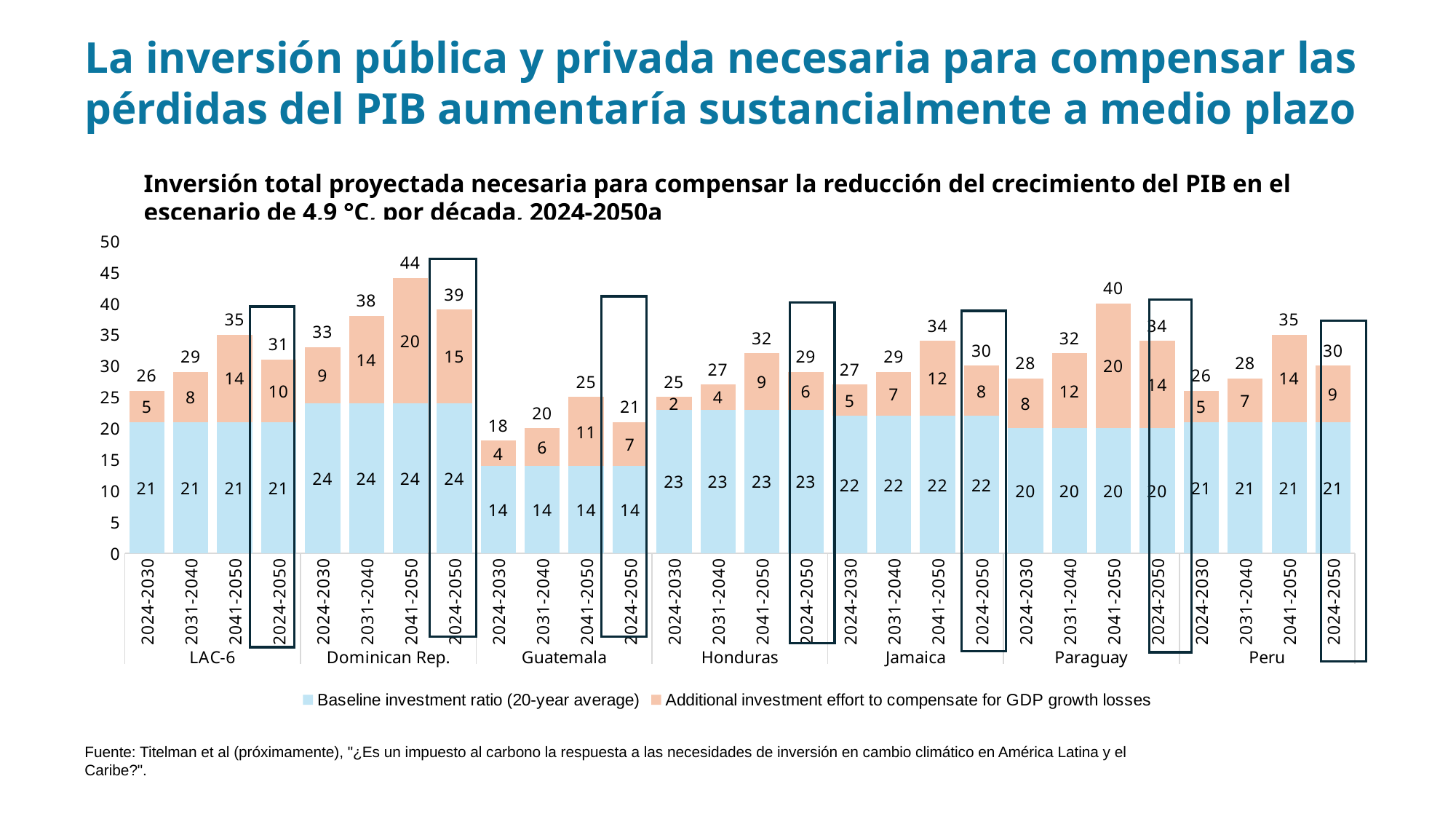
How many countries or groups are shown along the x axis? 7 Do the total values for Paraguay rise or fall from 2024-2030 to 2041-2050? Rise How many series does the legend list? 2 Which country has the lowest total bar in the 2024-2030 period? Guatemala What is the additional investment effort to compensate for GDP growth losses for Paraguay in 2041-2050? 20 What is the total value of the bar for Dominican Rep. in 2041-2050? 44 What is the difference between the total for Honduras in 2041-2050 and the total for Honduras in 2024-2030? 7 Which country has the highest total bar in the 2041-2050 period? Dominican Rep. Which is larger: the total for Jamaica in 2024-2050 or the total for Peru in 2024-2050? They are equal (30) What is the baseline investment ratio (20-year average) for Guatemala in 2024-2030? 14 What kind of chart is shown on the slide? Stacked bar chart Which is larger: the additional investment effort for LAC-6 in 2041-2050 or for Guatemala in 2041-2050? LAC-6 (14)